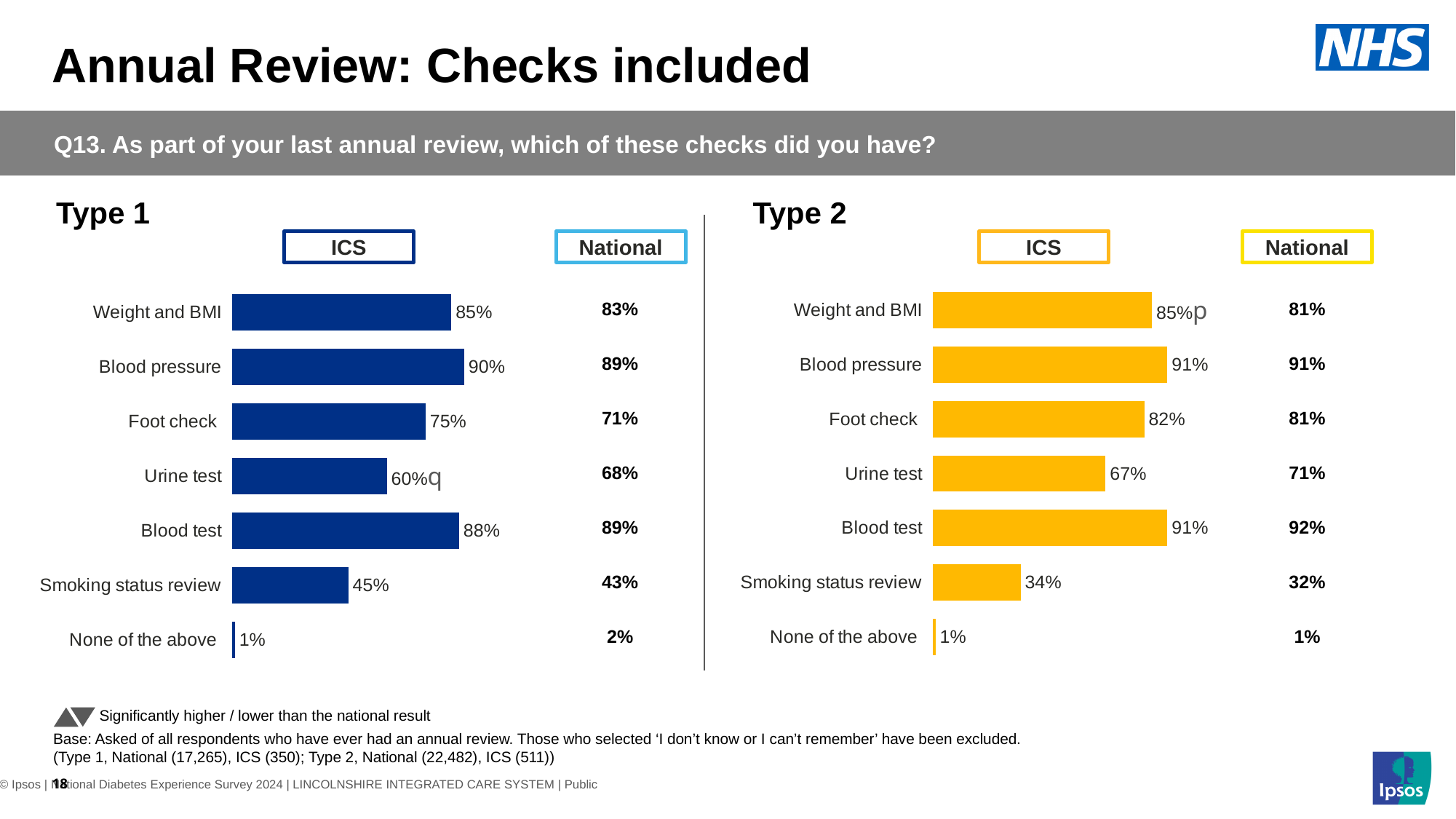
In the Type 2 chart, what is the National value for Blood test? 92% In the Type 1 chart, what is the difference between the ICS and National values for Urine test? 8 percentage points In the Type 2 chart, what is the ICS value for Smoking status review? 34% In the Type 2 chart, what is the difference between the ICS and National values for Weight and BMI? 4 percentage points In the Type 2 chart, which check has the lowest ICS value? None of the above How many checks are listed in the Type 2 chart? 7 In the Type 1 chart, what is the National value for Urine test? 68% What kind of chart is used for the Type 1 ICS results? Bar chart In the Type 1 chart, which check has the highest ICS value? Blood pressure In the Type 1 chart, is the ICS value for Smoking status review larger or smaller than the National value? larger What colour are the ICS bars in the Type 2 chart? Yellow In the Type 1 chart, what is the ICS value for Foot check? 75%